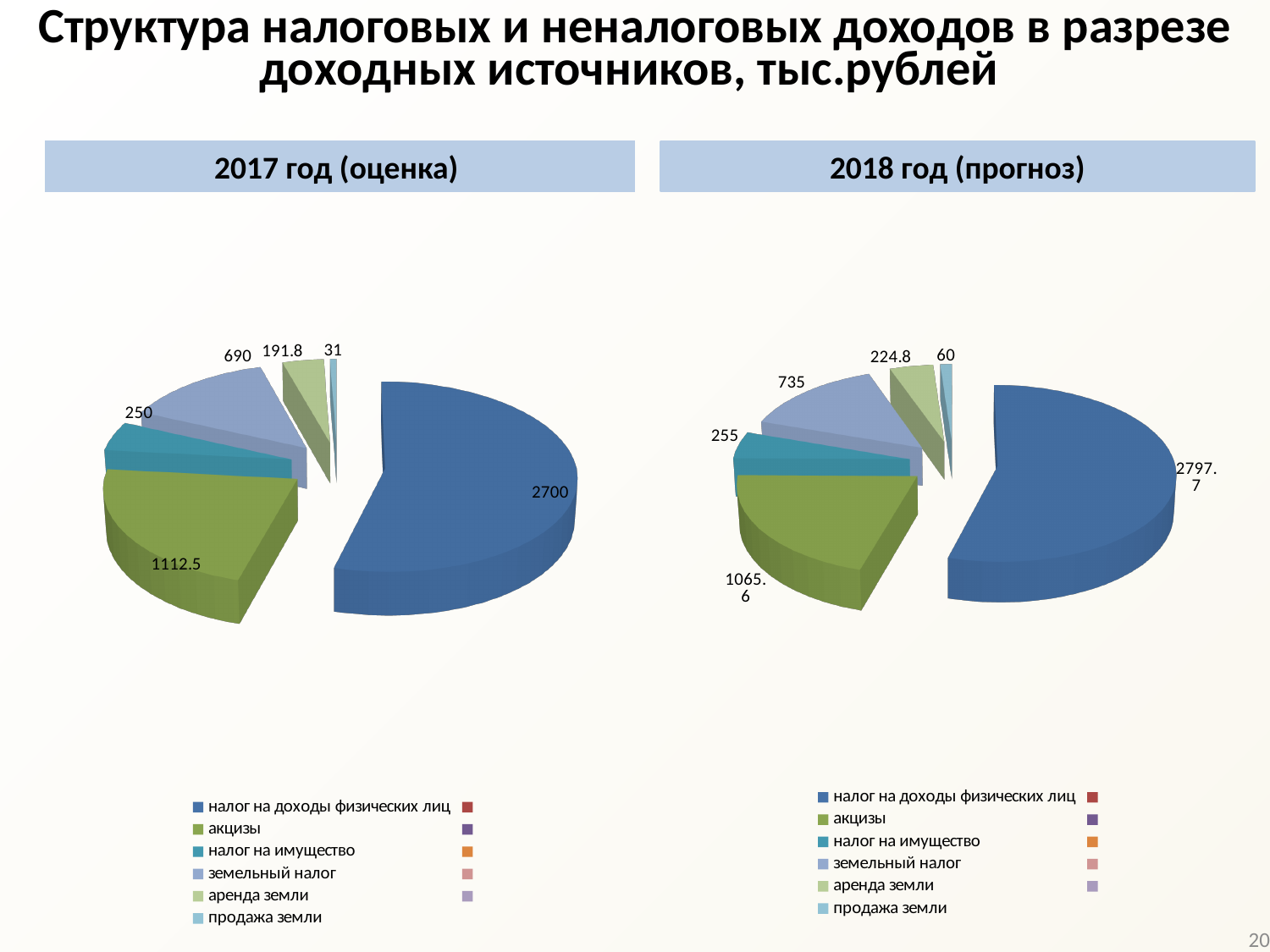
In the 2017 год (оценка) chart, what is the value for налог на доходы физических лиц? 2700 How many slices does the 2018 год (прогноз) pie chart have? 6 In the 2018 год (прогноз) chart, what is the value for продажа земли? 60 In the 2017 год (оценка) chart, what colour is the slice for акцизы? green In the 2017 год (оценка) chart, what is the value for акцизы? 1112.5 What is the difference between the земельный налог values in the 2018 год (прогноз) chart and the 2017 год (оценка) chart? 45 In the 2018 год (прогноз) chart, which category has the largest slice? налог на доходы физических лиц What is the difference between the налог на доходы физических лиц value in the 2018 год (прогноз) chart and in the 2017 год (оценка) chart? 97.7 Which is larger: акцизы in the 2017 год (оценка) chart or акцизы in the 2018 год (прогноз) chart? 2017 год (оценка) In the 2018 год (прогноз) chart, what is the value for земельный налог? 735 What type of chart is used for the 2017 год (оценка) data? pie chart In the 2017 год (оценка) chart, which category has the smallest slice? продажа земли